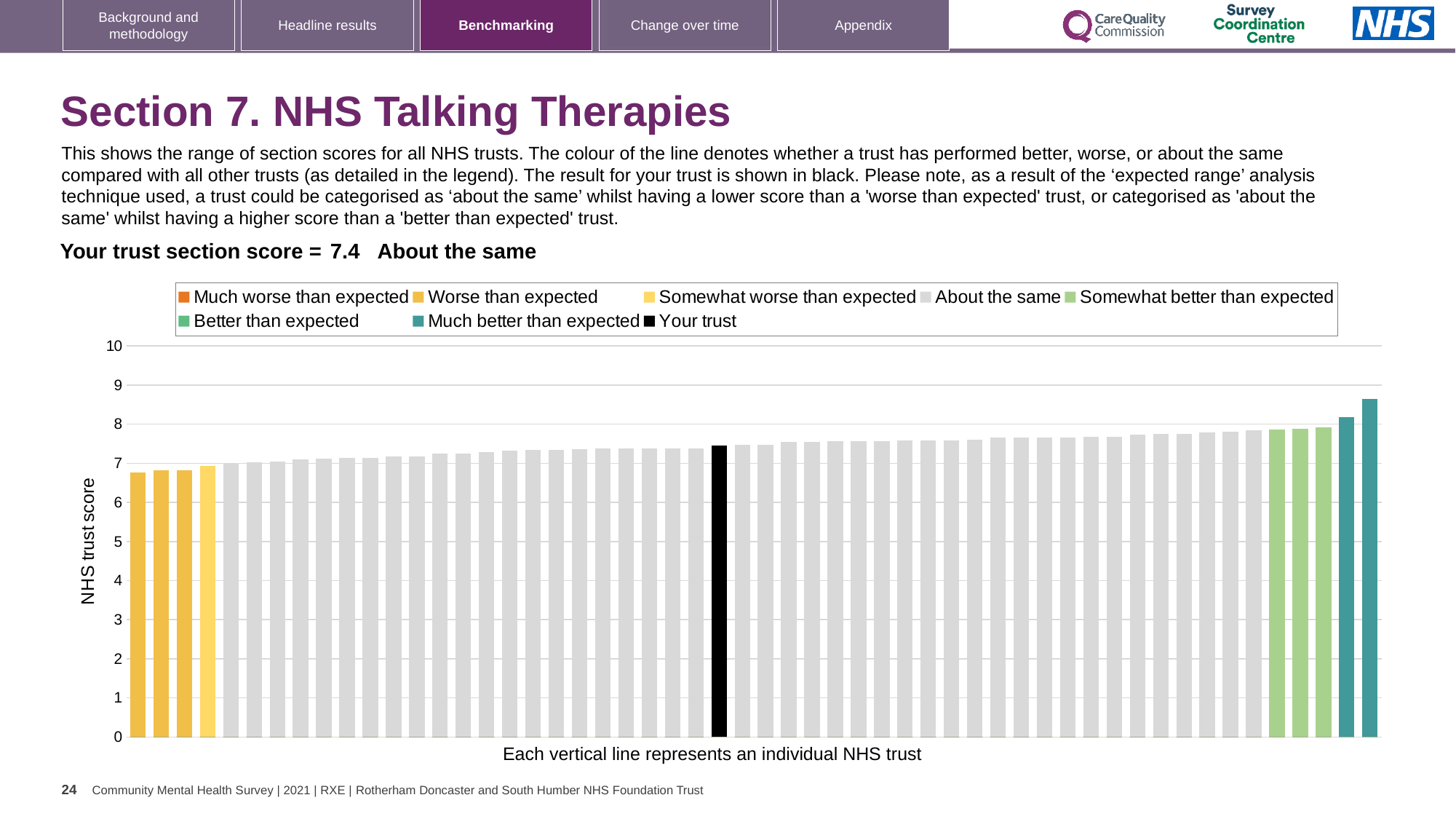
Is the shortest bar in the chart greater or less than 7? less Is the value for your trust greater or less than 7? greater Which benchmarking category is your trust placed in for this section? About the same What kind of chart is shown on the slide? bar chart What is the section score for your trust shown on the slide? 7.4 Is the tallest bar in the chart greater or less than 8? greater Which legend category does the tallest bar belong to? Much better than expected Which legend category does the shortest bar belong to? Worse than expected Do the bar values rise or fall from left to right along the x axis? rise How many entries does the chart legend list? 8 What colour is the bar representing your trust? black